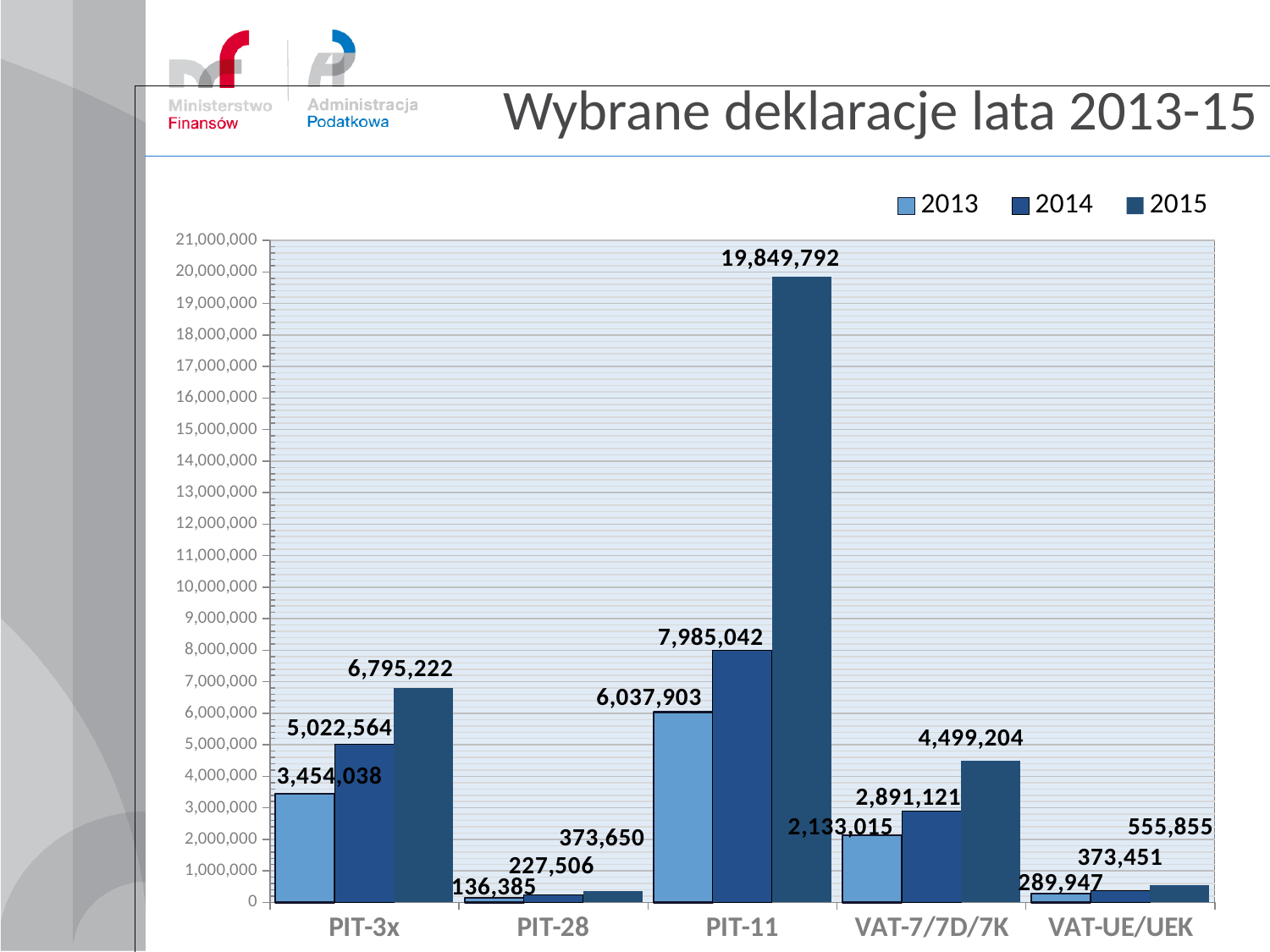
What kind of chart is shown on the slide? Bar chart How many categories are shown on the x axis? 5 What is the difference between the 2015 and 2014 values for PIT-3x? 1,772,658 Which category has the lowest value in 2013? PIT-28 Which category has the highest value in 2015? PIT-11 How many series does the legend list? 3 What is the value for VAT-7/7D/7K in 2014? 2,891,121 What is the title of the slide? Wybrane deklaracje lata 2013-15 What is the value for PIT-11 in 2015? 19,849,792 Which is larger: the 2014 value for PIT-11 or the 2015 value for PIT-3x? 2014 value for PIT-11 What is the value for VAT-UE/UEK in 2015? 555,855 What is the value for PIT-3x in 2013? 3,454,038